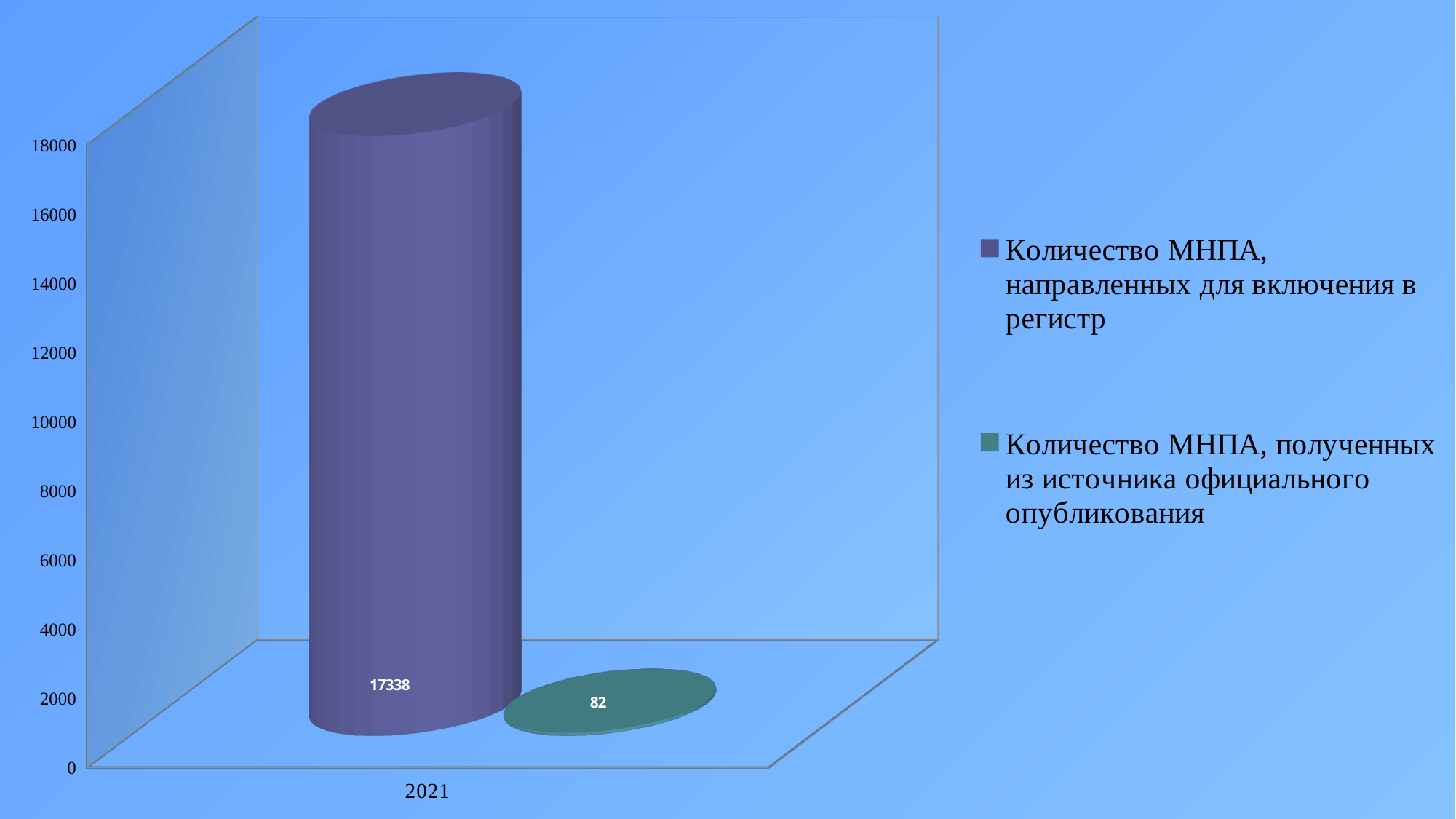
How many categories are shown on the x axis? 1 Which series has the higher value in 2021? Количество МНПА, направленных для включения в регистр What is the value for "Количество МНПА, полученных из источника официального опубликования" in 2021? 82 Is the value for "Количество МНПА, направленных для включения в регистр" greater or less than 16000? greater What is the difference between the two values shown for 2021? 17256 Is the value for "Количество МНПА, полученных из источника официального опубликования" greater or less than 2000? less How many series does the legend list? 2 Which series has the lower value in 2021? Количество МНПА, полученных из источника официального опубликования What colour is the bar for "Количество МНПА, полученных из источника официального опубликования"? green What is the value for "Количество МНПА, направленных для включения в регистр" in 2021? 17338 Is the value for "Количество МНПА, направленных для включения в регистр" larger or smaller than the value for "Количество МНПА, полученных из источника официального опубликования"? larger What kind of chart is shown on the slide? bar chart